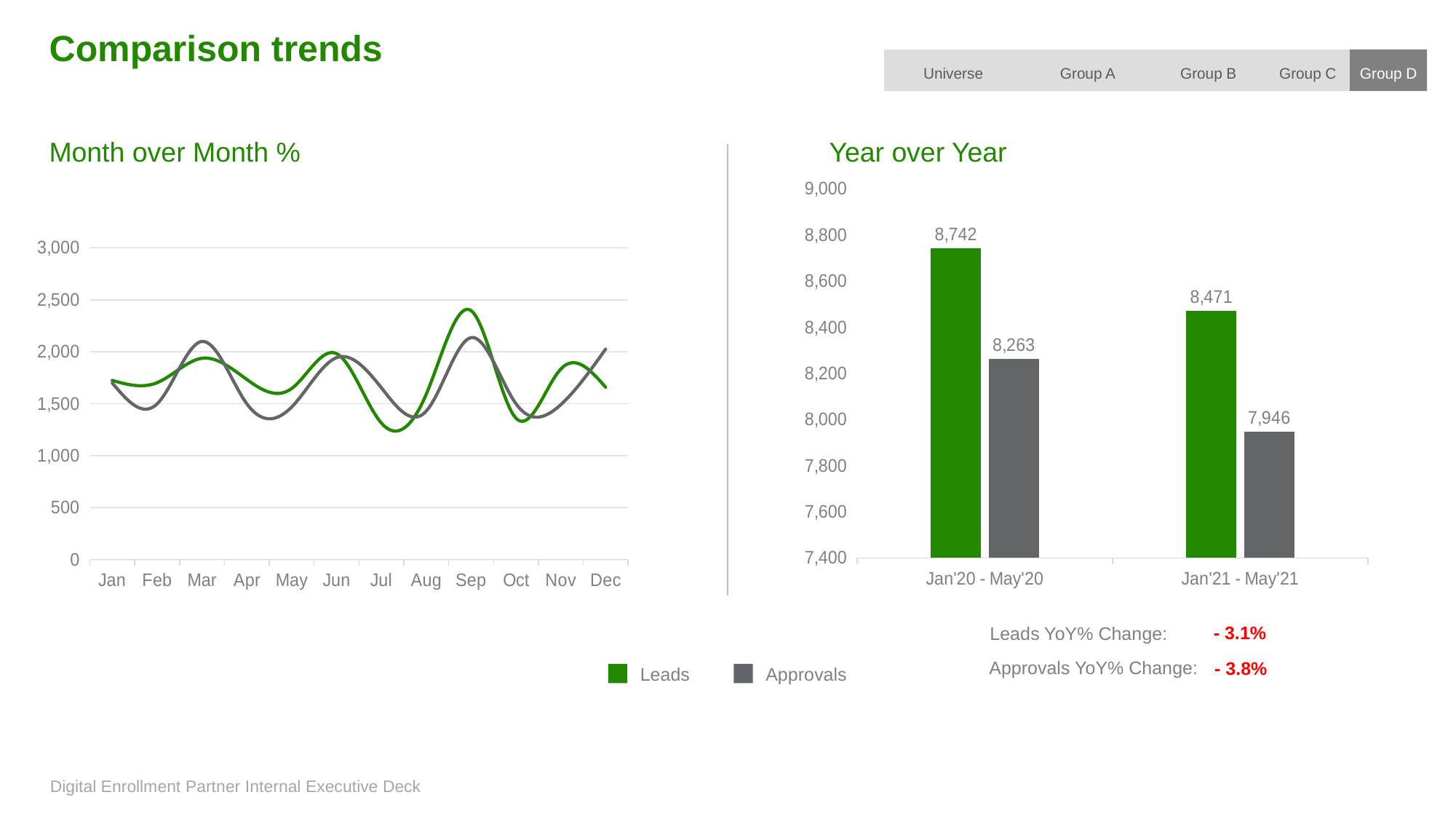
In the Year over Year chart, what is the Leads value for Jan'20 - May'20? 8,742 In the Year over Year chart, which is larger: Approvals for Jan'20 - May'20 or Leads for Jan'21 - May'21? Leads for Jan'21 - May'21 In the Year over Year chart, which bar is the lowest? Approvals, Jan'21 - May'21 In the Year over Year chart, what is the difference between the Leads values for Jan'20 - May'20 and Jan'21 - May'21? 271 In the Year over Year chart, what is the difference between Leads and Approvals for Jan'21 - May'21? 525 How many months are shown on the x axis of the Month over Month % chart? 12 What kind of chart is the Month over Month % chart? Line chart In the Year over Year chart, what is the Approvals value for Jan'21 - May'21? 7,946 In the Month over Month % chart, is the Leads value for Jul greater or less than 1,500? less In the Year over Year chart, what is the Approvals value for Jan'20 - May'20? 8,263 In the Month over Month % chart, in which month does the Leads line reach its highest value? Sep What kind of chart is the Year over Year chart? Bar chart